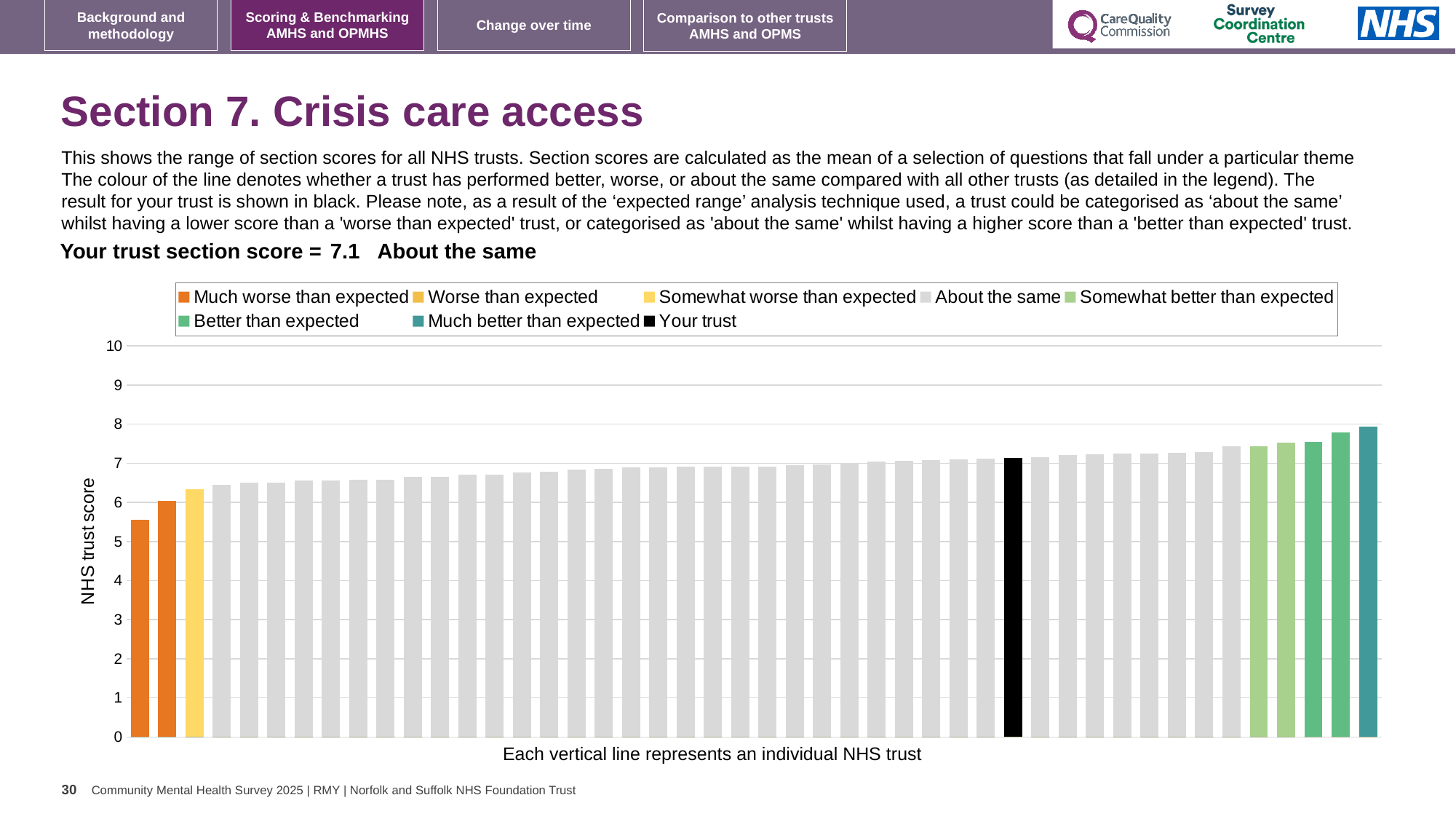
What kind of chart is shown on the slide? Bar chart Which legend category does the tallest bar belong to? Much better than expected What is the section score for your trust shown on the slide? 7.1 Which legend category does the shortest bar belong to? Much worse than expected What is the label on the vertical axis? NHS trust score Is the value for the tallest bar greater or less than 7? greater How many bars are coloured orange (Much worse than expected)? 2 What colour is the bar representing your trust? Black Is the value for the lowest bar greater or less than 6? less How many entries does the chart legend list? 8 Do the bar values rise or fall from left to right along the x axis? rise Which category is your trust's section score placed in? About the same